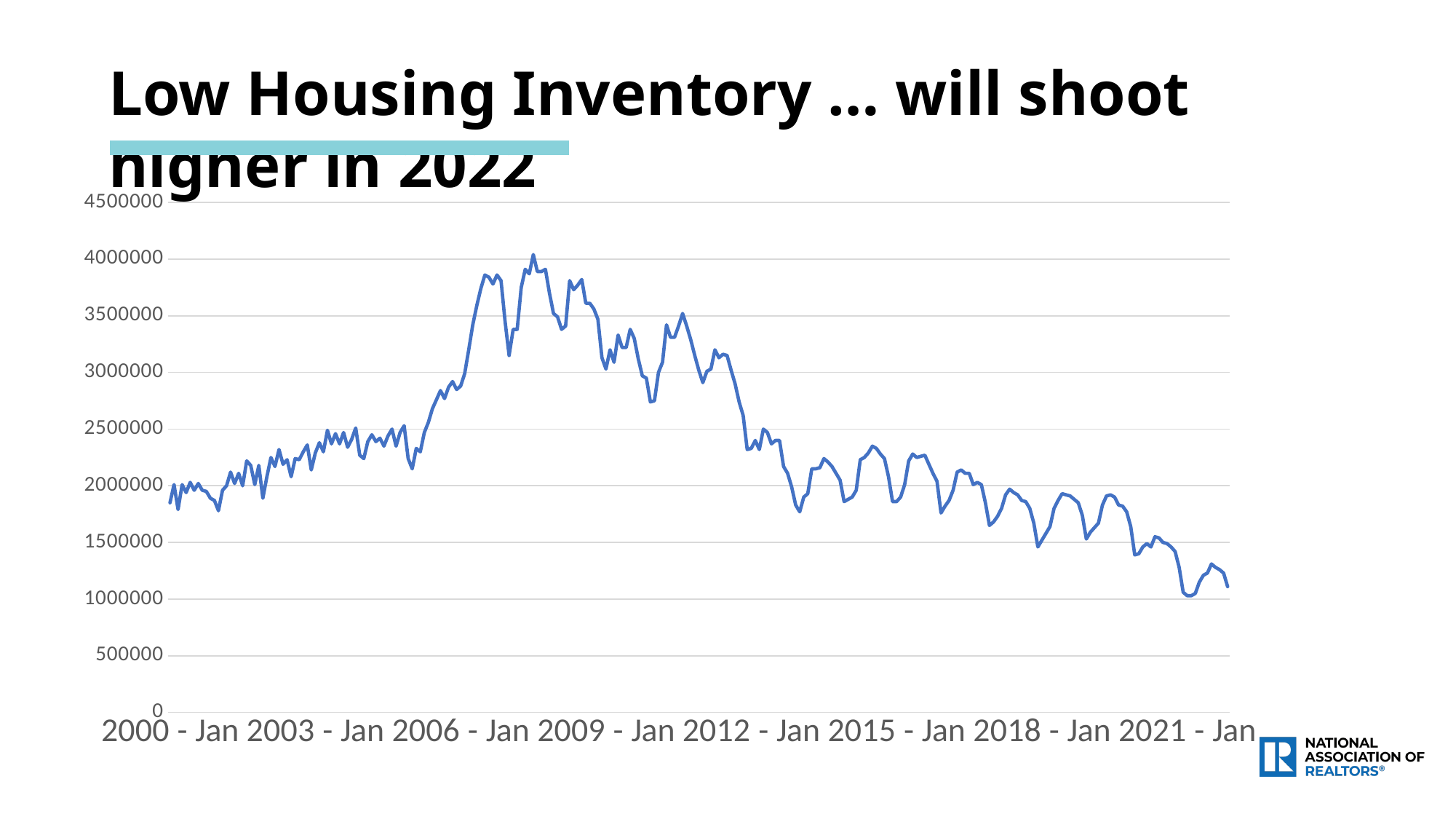
Does the line generally rise or fall between 2009 - Jan and 2021 - Jan? fall Is the peak value of the line greater or less than 4000000? greater Which is larger, the value at 2003 - Jan or the value at 2006 - Jan? 2006 - Jan Is the value at 2021 - Jan greater or less than 1500000? less Is the value at 2006 - Jan greater or less than 2500000? greater What is the title of the slide containing the chart? Low Housing Inventory … will shoot higher in 2022 What kind of chart is shown on the slide? line chart What is the highest value shown on the y axis of the chart? 4500000 Which is larger, the value at 2009 - Jan or the value at 2021 - Jan? 2009 - Jan How many year labels are shown along the x axis of the chart? 8